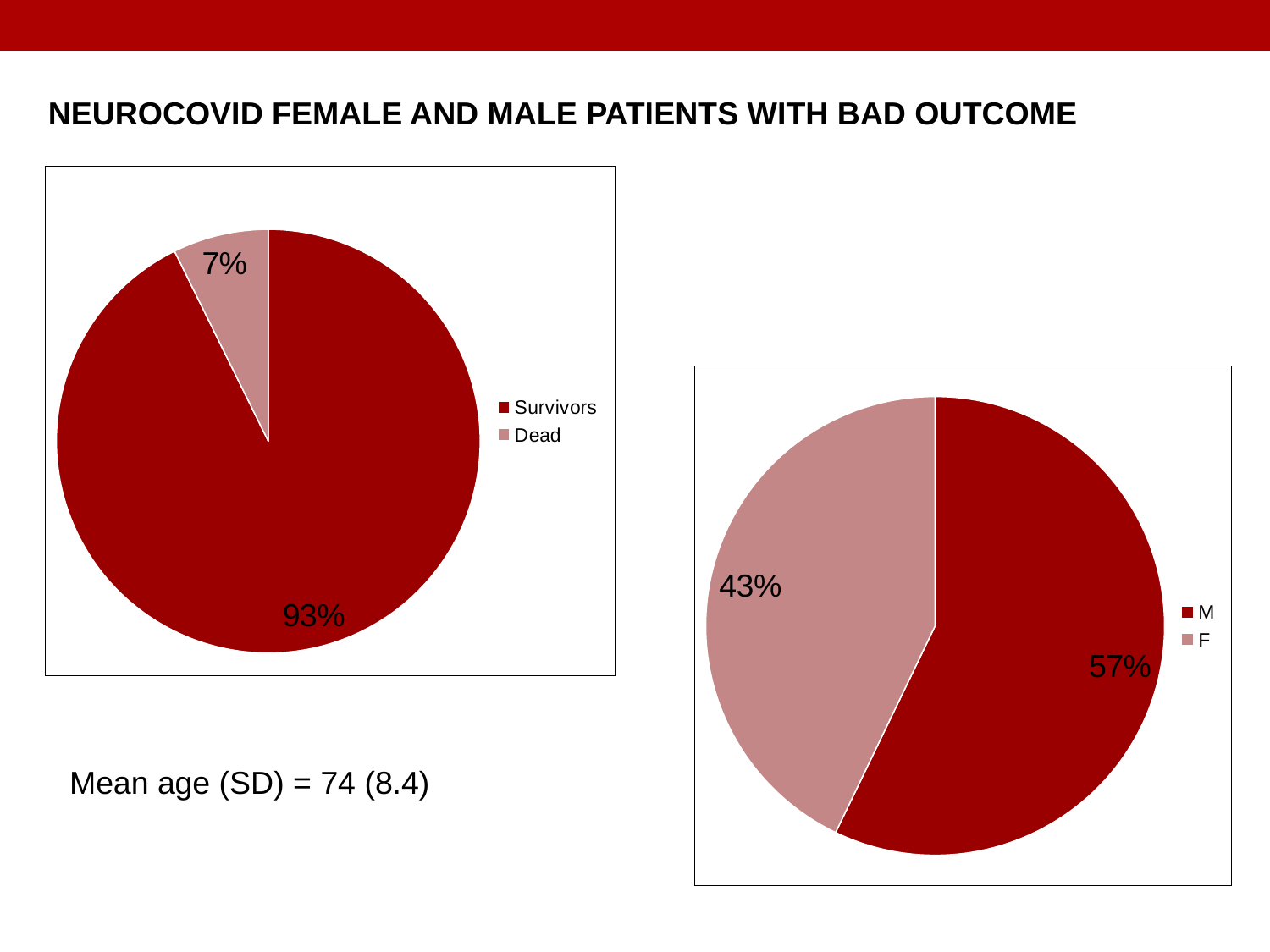
What kind of chart is the chart on the right of the slide? Pie chart In the left pie chart (Survivors/Dead), what percentage is labelled for Dead? 7% In the right pie chart (M/F), which slice is the smallest? F In the right pie chart (M/F), which is larger, M or F? M What entries does the legend of the right pie chart list? M and F In the right pie chart (M/F), what is the difference in percentage points between M and F? 14 In the left pie chart (Survivors/Dead), which slice is the largest? Survivors In the left pie chart (Survivors/Dead), what is the difference in percentage points between Survivors and Dead? 86 How many slices does the left pie chart (Survivors/Dead) have? 2 In the right pie chart (M/F), what percentage is labelled for M? 57% In the right pie chart (M/F), what percentage is labelled for F? 43% In the left pie chart (Survivors/Dead), what percentage is labelled for Survivors? 93%